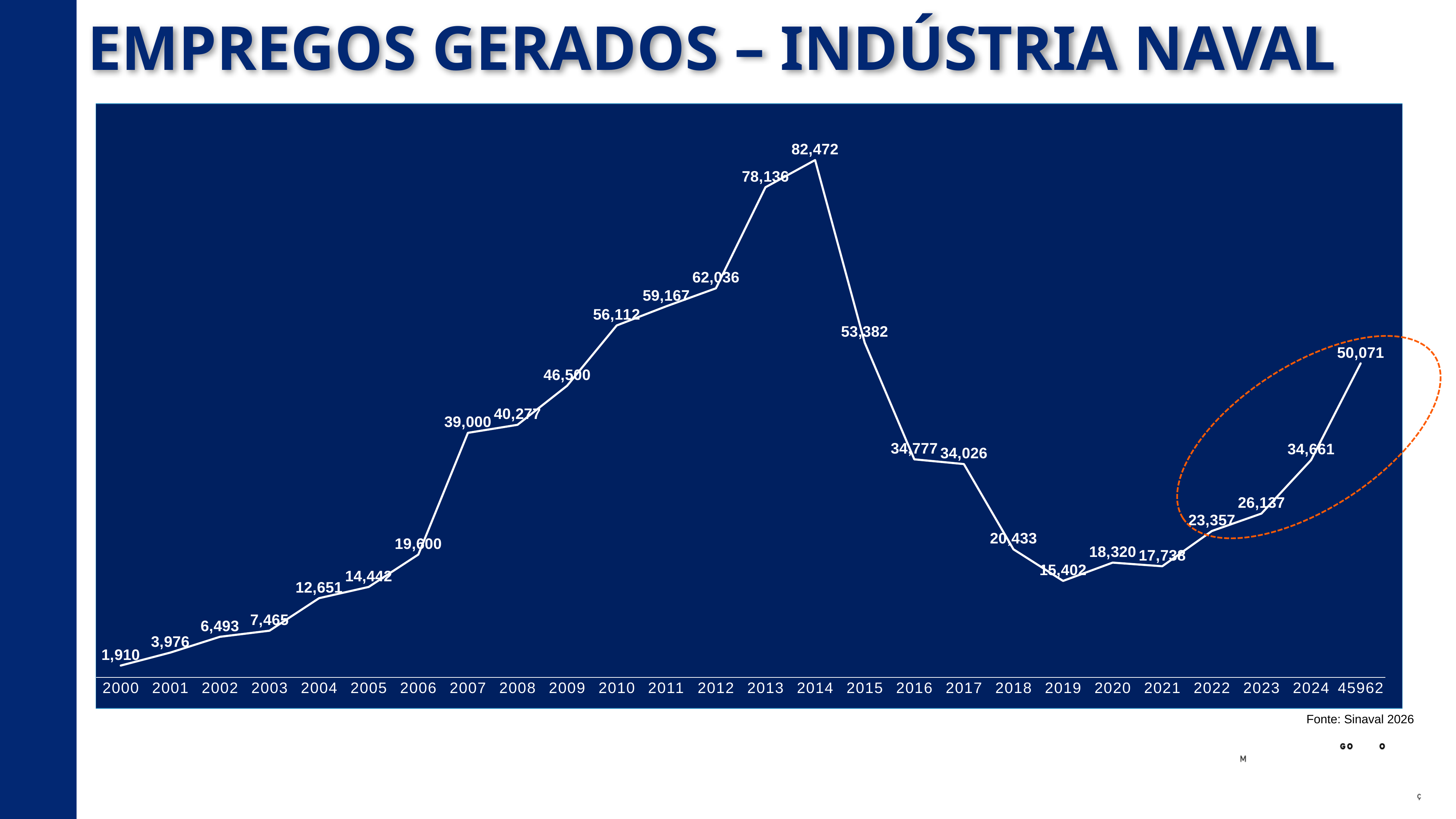
What is the value for 2000? 1,910 What is the value for 2019? 15,402 What type of chart is shown on the slide? line chart What is the difference between the values for 2024 and 2023? 8,524 Do the values rise or fall from 2014 to 2019? fall What is the value for 2014? 82,472 What is the title of the slide? EMPREGOS GERADOS – INDÚSTRIA NAVAL Which year has the highest value? 2014 What is the value for 2024? 34,661 Which is larger, the value for 2016 or the value for 2017? 2016 What is the difference between the values for 2014 and 2013? 4,336 Which year has the lowest value? 2000